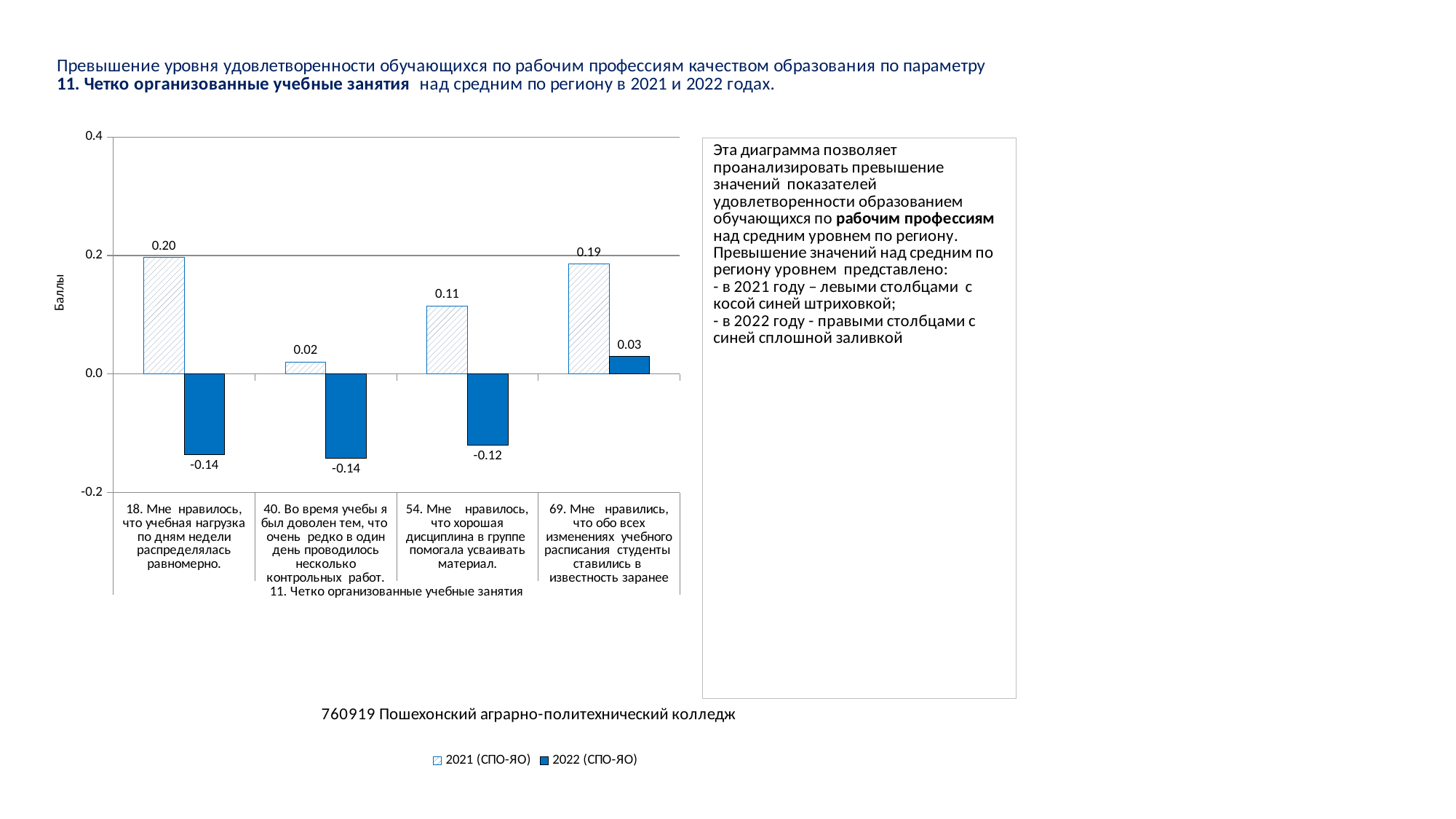
What is the 2022 (СПО-ЯО) value for category 69 ("Мне нравились, что обо всех изменениях учебного расписания студенты ставились в известность заранее")? 0.03 Which category has the lowest 2021 (СПО-ЯО) value? 40. Во время учебы я был доволен тем, что очень редко в один день проводилось несколько контрольных работ. What is the 2022 (СПО-ЯО) value for category 54 ("Мне нравилось, что хорошая дисциплина в группе помогала усваивать материал")? -0.12 What is the difference between the 2021 (СПО-ЯО) and 2022 (СПО-ЯО) values for category 18? 0.34 For category 69, which series has the larger value: 2021 (СПО-ЯО) or 2022 (СПО-ЯО)? 2021 (СПО-ЯО) How many categories are shown on the x axis of the chart? 4 Which category has the highest 2021 (СПО-ЯО) value? 18. Мне нравилось, что учебная нагрузка по дням недели распределялась равномерно. How many series does the chart legend list? 2 What is the label of the vertical axis of the chart? Баллы Which category has the highest 2022 (СПО-ЯО) value? 69. Мне нравились, что обо всех изменениях учебного расписания студенты ставились в известность заранее What type of chart is shown on the slide? Bar chart What is the 2021 (СПО-ЯО) value for category 18 ("Мне нравилось, что учебная нагрузка по дням недели распределялась равномерно")? 0.20